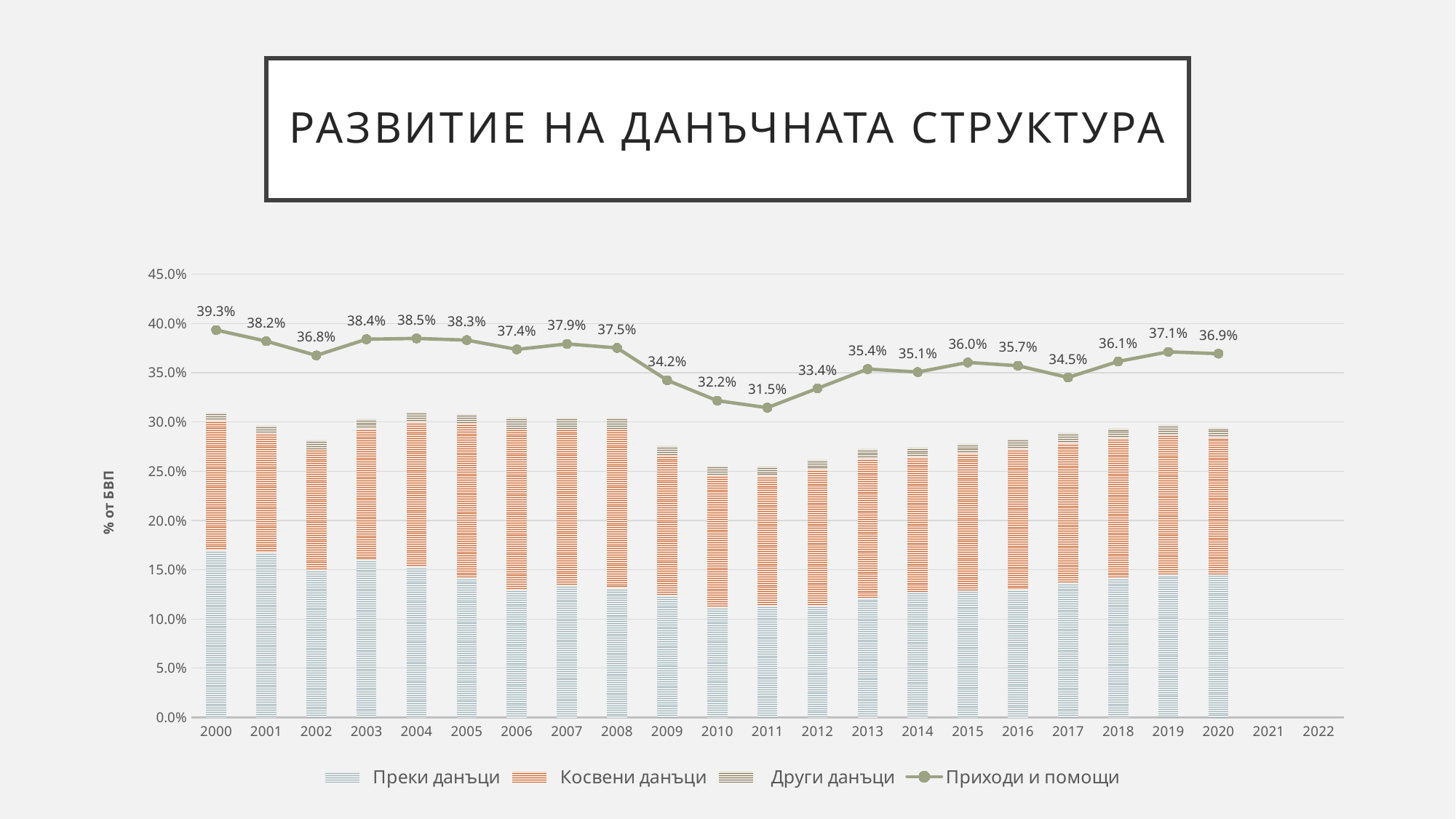
What is the difference between Приходи и помощи in 2000 and in 2011? 7.8 percentage points How many series does the legend list? 4 In which year is Приходи и помощи lowest? 2011 What is the value of Приходи и помощи for 2020? 36.9% Is the total height of the stacked bar for 2010 greater or less than 30.0%? less What is the value of Приходи и помощи for 2000? 39.3% Does Приходи и помощи rise or fall from 2008 to 2011? fall In which year is Приходи и помощи highest? 2000 Which year has a higher value of Приходи и помощи, 2002 or 2003? 2003 What is the title of the slide? РАЗВИТИЕ НА ДАНЪЧНАТА СТРУКТУРА What is the value of Приходи и помощи for 2011? 31.5% Is the value for Преки данъци in 2000 greater or less than 15.0%? greater